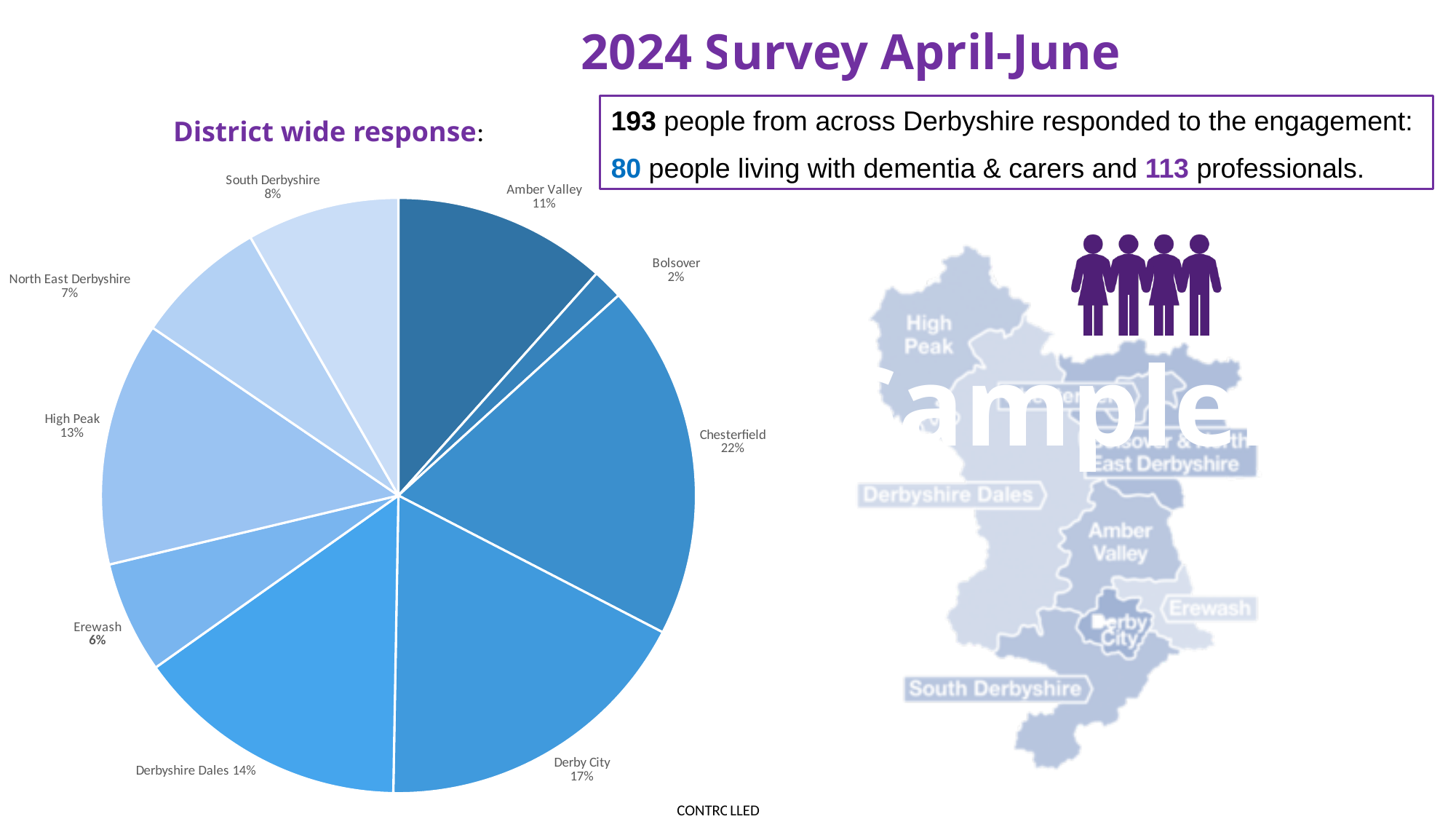
How many districts are shown in the pie chart? 9 Which has a larger share in the pie chart, Derbyshire Dales or Amber Valley? Derbyshire Dales What share of the district wide response pie chart does Chesterfield account for? 22% Which district has the largest slice in the pie chart? Chesterfield What percentage is shown for Bolsover in the pie chart? 2% What is the title of the pie chart? District wide response What percentage is shown for North East Derbyshire in the pie chart? 7% What type of chart is used to show the district wide response? Pie chart What percentage is shown for Derby City in the pie chart? 17% What is the combined share of South Derbyshire and North East Derbyshire in the pie chart? 15% Which district has the smallest slice in the pie chart? Bolsover What is the difference in percentage points between High Peak and Erewash in the pie chart? 7